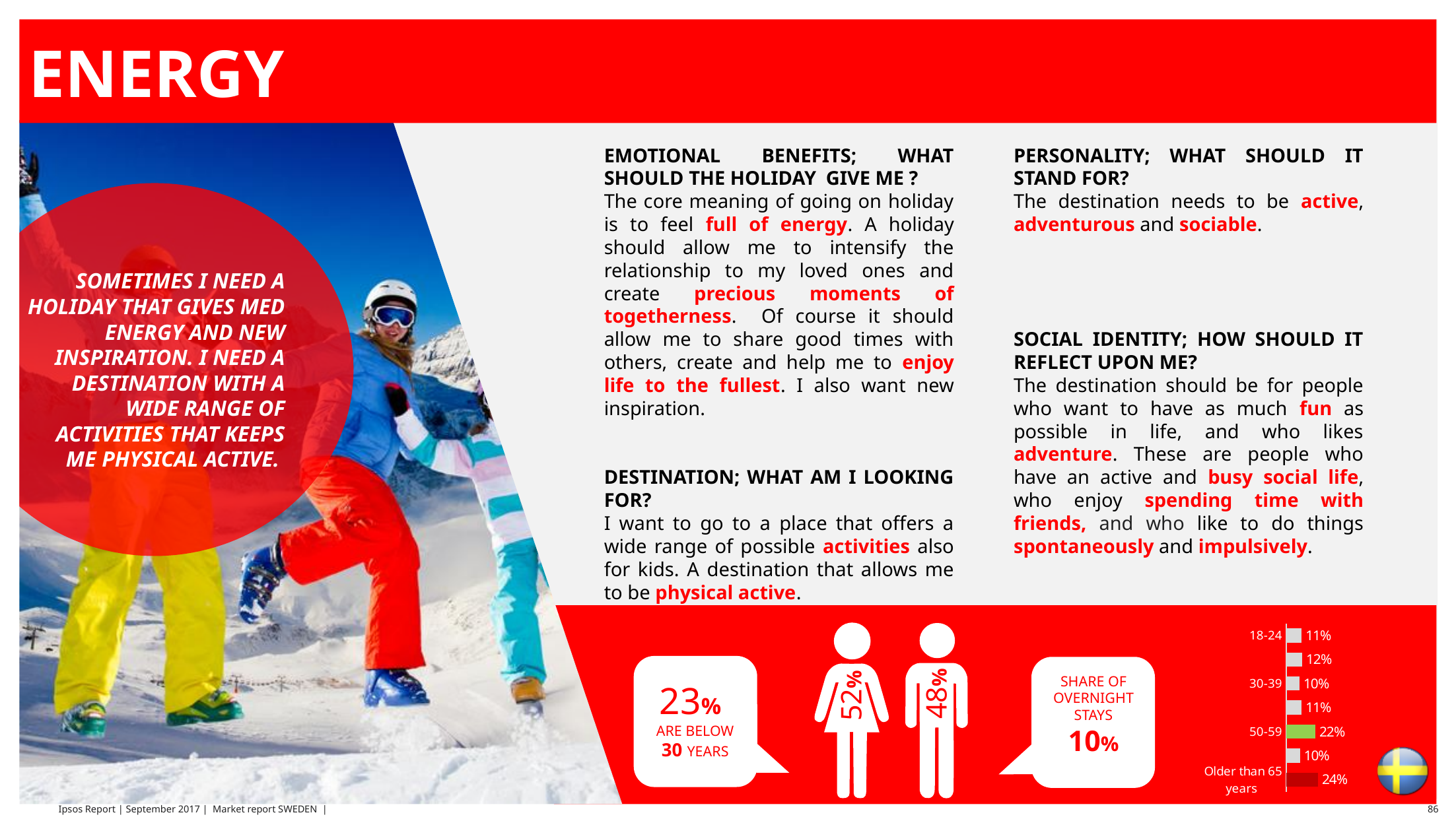
In the age-group bar chart, which is larger, the value for Older than 65 years or the value for 50-59? Older than 65 years In the age-group bar chart, what is the value for 18-24? 11% In the age-group bar chart, what is the value for Older than 65 years? 24% In the age-group bar chart, what colour is the bar for 50-59? green In the age-group bar chart, which is larger, the value for 50-59 or the value for 30-39? 50-59 In the age-group bar chart, which age group has the highest value? Older than 65 years How many bars are plotted in the age-group bar chart? 7 What kind of chart is shown at the bottom right of the slide? bar chart In the age-group bar chart, what is the value for 50-59? 22% In the age-group bar chart, what is the value for 30-39? 10% In the age-group bar chart, what is the difference between the values for Older than 65 years and 30-39? 14 percentage points In the age-group bar chart, what is the difference between the values for 50-59 and 18-24? 11 percentage points